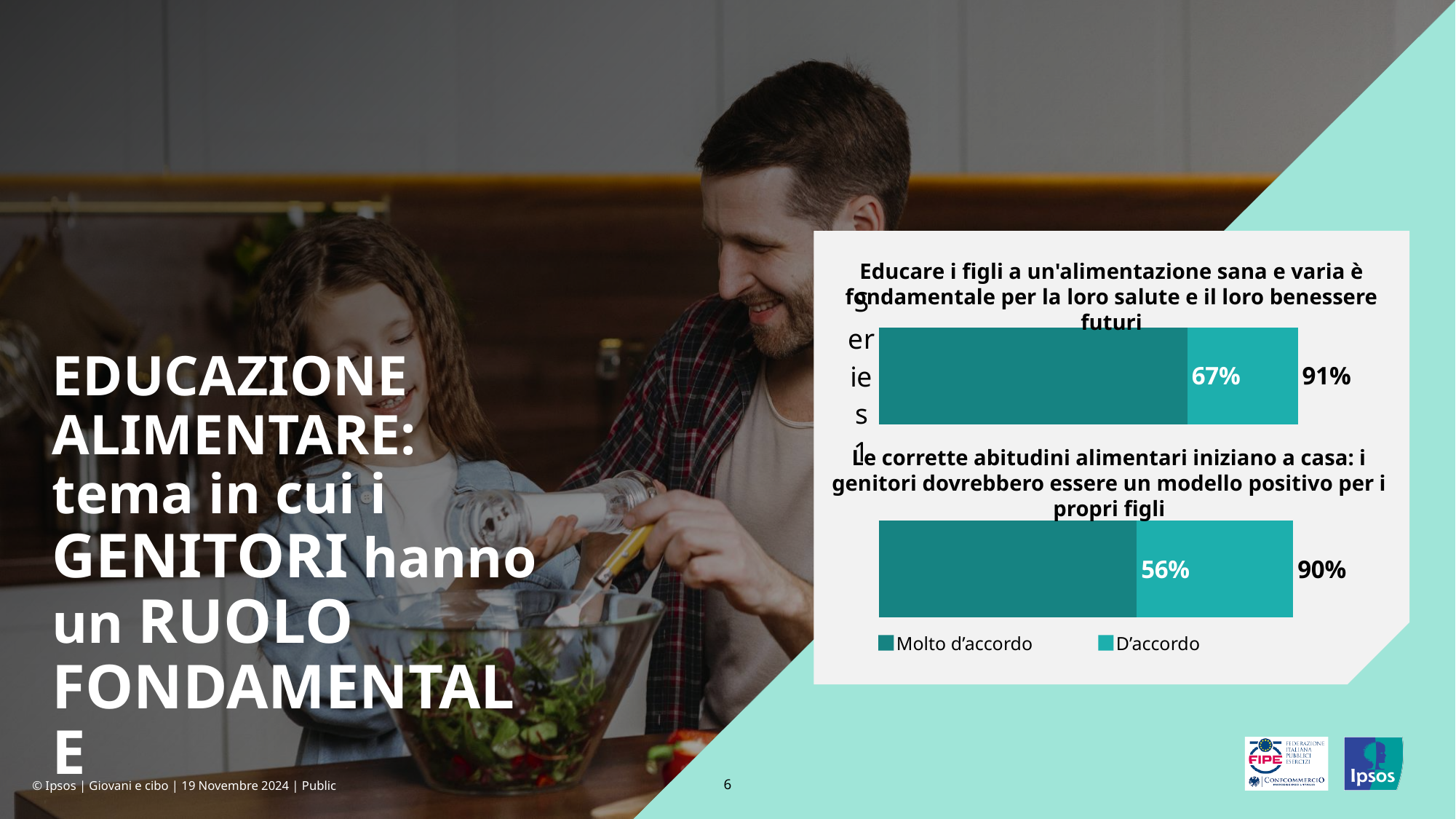
What is the difference between the 'Molto d'accordo' values of the top chart (67%) and the bottom chart (56%)? 11% In the bottom chart ('Le corrette abitudini alimentari iniziano a casa...'), what percentage is shown for 'Molto d'accordo'? 56% What type of chart is used on the slide? Stacked bar chart In the top chart ('Educare i figli a un'alimentazione sana e varia...'), what is the total percentage shown at the end of the bar? 91% In the bottom chart ('Le corrette abitudini alimentari iniziano a casa...'), what is the total percentage shown at the end of the bar? 90% In the bottom chart, what is the difference between the total (90%) and the 'Molto d'accordo' value (56%), i.e. the 'D'accordo' share? 34% How many series does the legend list for the charts? 2 In the top chart, what is the difference between the total (91%) and the 'Molto d'accordo' value (67%), i.e. the 'D'accordo' share? 24% Which chart has the higher 'Molto d'accordo' value, the top chart or the bottom chart? The top chart What are the two legend entries shown below the charts? Molto d'accordo and D'accordo In the top chart ('Educare i figli a un'alimentazione sana e varia...'), what percentage is shown for 'Molto d'accordo'? 67% In the top chart, is the 'Molto d'accordo' segment larger or smaller than the 'D'accordo' segment? Larger